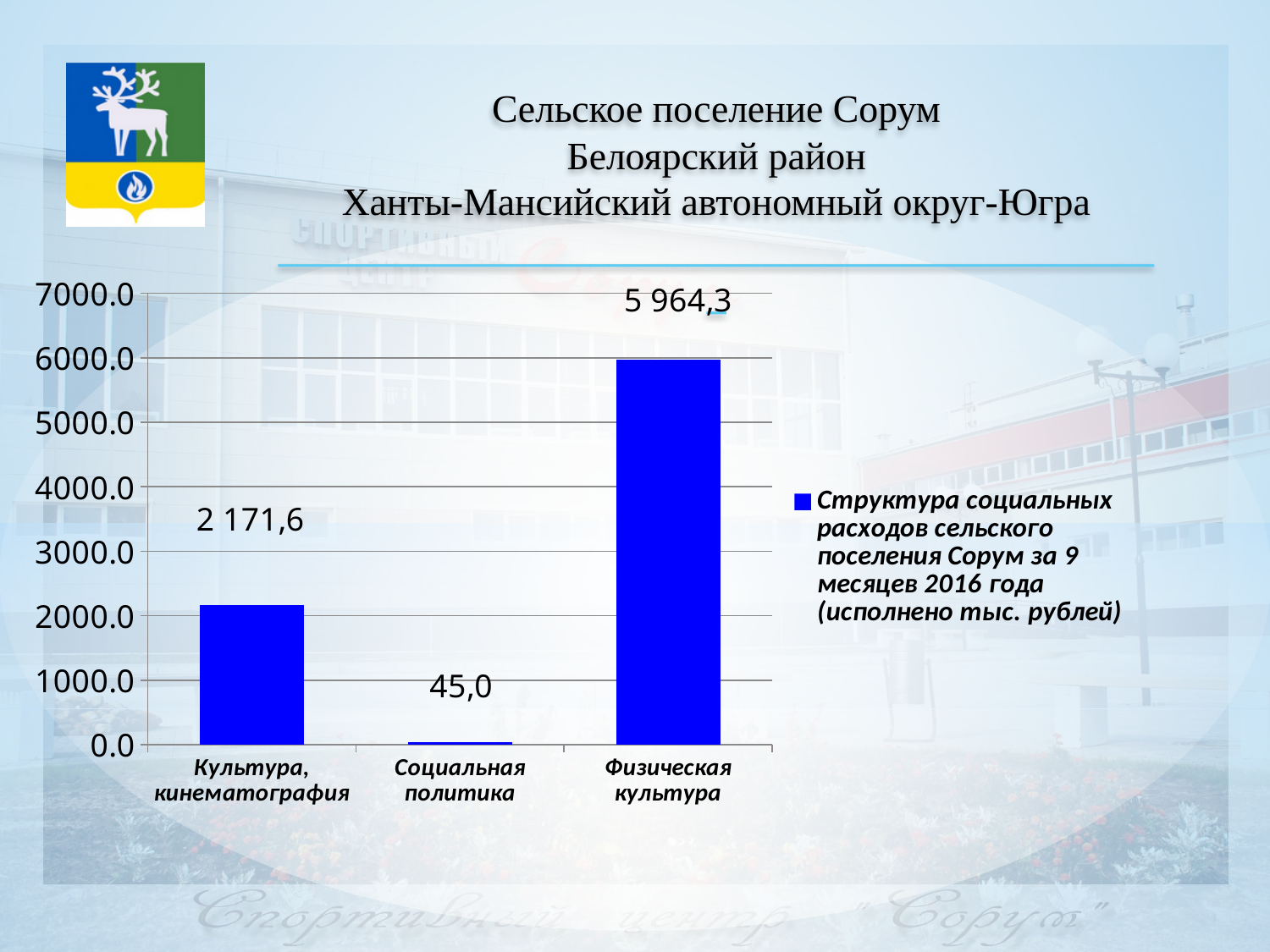
What is the difference between the values for Физическая культура and Культура, кинематография? 3 792,7 Which category has the lowest value? Социальная политика Which category has the highest value? Физическая культура How many categories are shown on the chart? 3 What is the value for Физическая культура? 5 964,3 What kind of chart is shown on the slide? bar chart What is the difference between the values for Культура, кинематография and Социальная политика? 2 126,6 What is the value for Социальная политика? 45,0 What is the value for Культура, кинематография? 2 171,6 How many series does the legend list? 1 Is the value for Физическая культура greater or less than 5000? greater Which is larger, the value for Культура, кинематография or the value for Физическая культура? Физическая культура